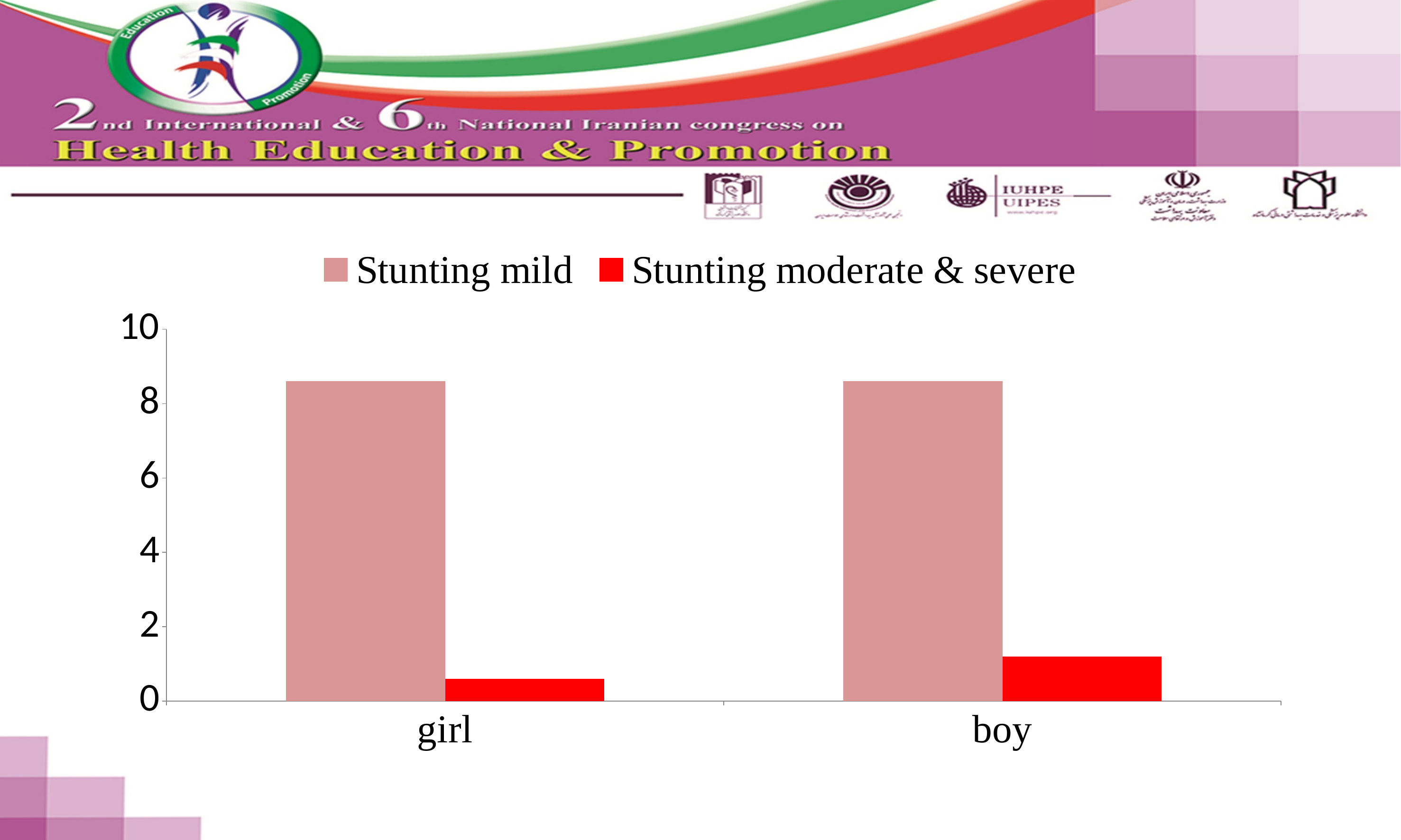
For girl, which series has the larger value, Stunting mild or Stunting moderate & severe? Stunting mild Is the value for Stunting moderate & severe for boy greater or less than 2? less Is the value for Stunting mild for girl greater or less than 8? greater Which series is drawn in bright red in the chart? Stunting moderate & severe How many categories are shown on the x axis of the chart? 2 Is the value for Stunting moderate & severe for girl greater or less than 2? less Which category has the lowest value for Stunting moderate & severe? girl Which category has the larger value for Stunting moderate & severe, girl or boy? boy What are the two series named in the chart's legend? Stunting mild; Stunting moderate & severe How many series does the chart's legend list? 2 What kind of chart is shown on the slide? bar chart